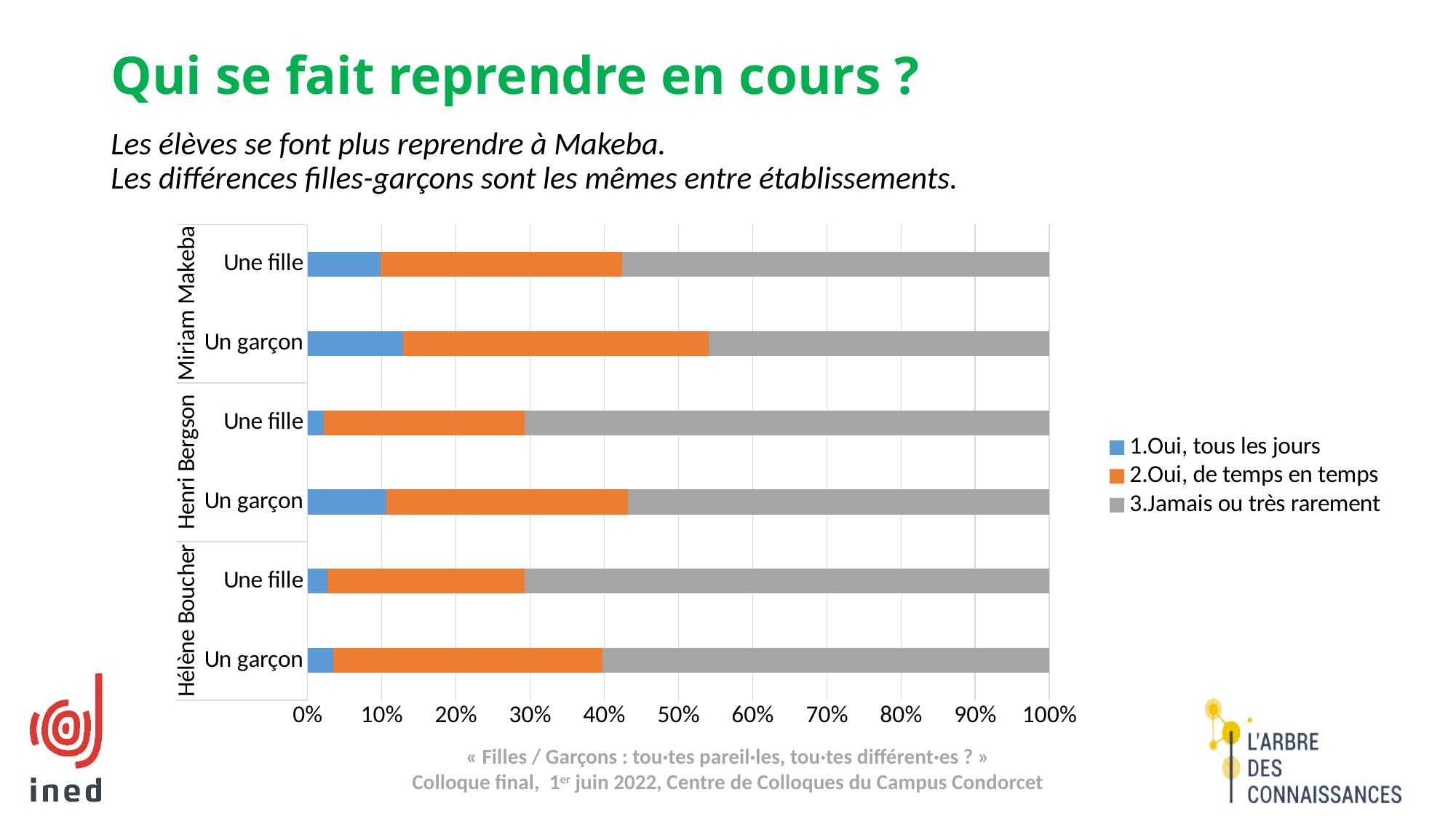
Is the "1.Oui, tous les jours" share for "Un garçon" at Miriam Makeba greater or less than 10%? greater What is the title of the slide containing the chart? Qui se fait reprendre en cours ? Which bar has the smallest "3.Jamais ou très rarement" segment? Un garçon (Miriam Makeba) How many bars are plotted in the chart? 6 Is the "1.Oui, tous les jours" share for "Une fille" at Henri Bergson greater or less than 10%? less Is the "1.Oui, tous les jours" share for "Un garçon" at Hélène Boucher greater or less than 10%? less What kind of chart is shown on the slide? Stacked bar chart Which bar has the largest "1.Oui, tous les jours" segment? Un garçon (Miriam Makeba) What value does each stacked bar reach on the x axis? 100% How many series does the chart legend list? 3 Which colour represents the series "1.Oui, tous les jours" in the chart? Blue Is the "1.Oui, tous les jours" segment larger for "Un garçon" at Miriam Makeba or for "Une fille" at Henri Bergson? Un garçon at Miriam Makeba